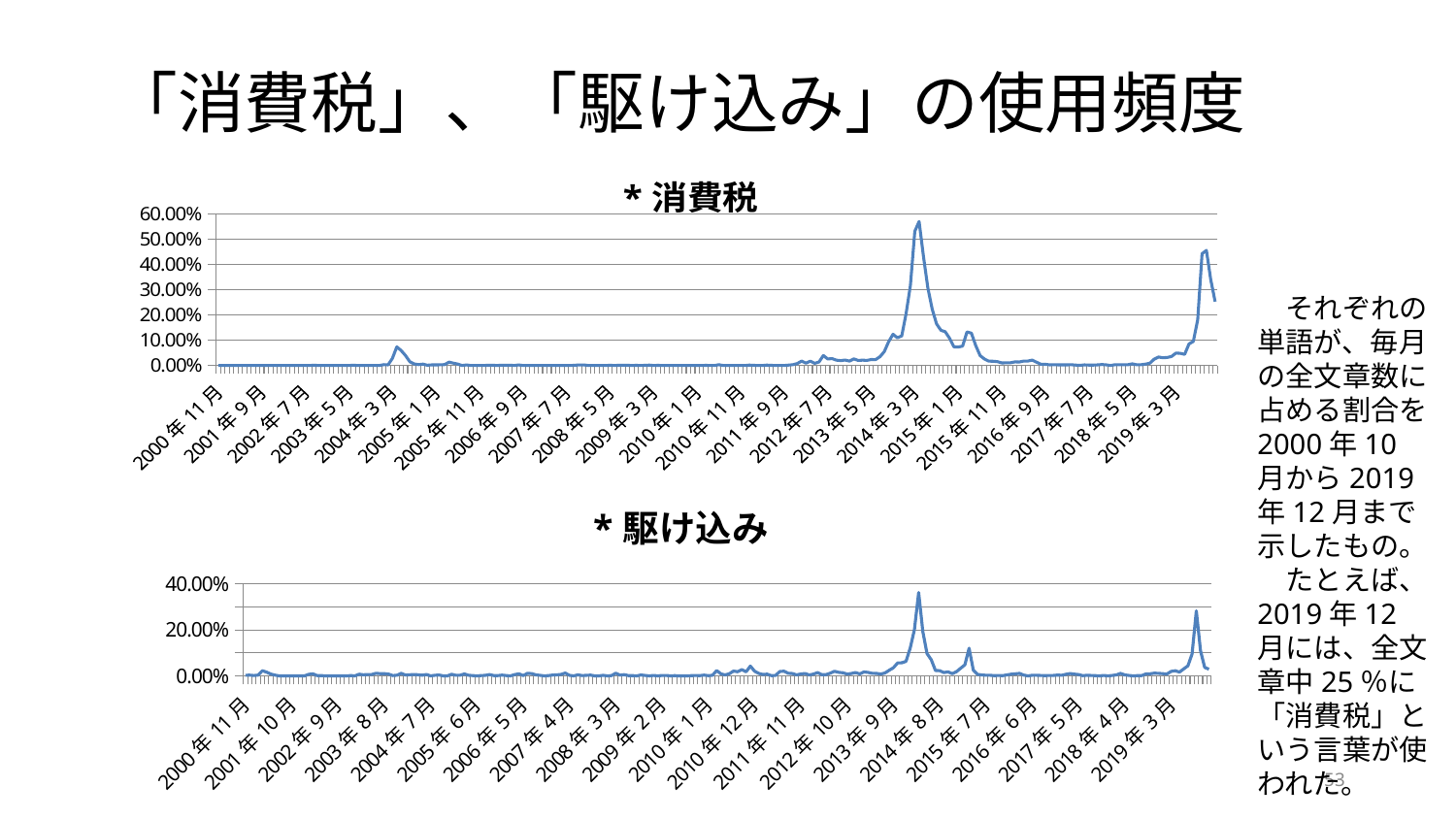
In the top chart ＊消費税, is the small peak near 2004年3月 greater or less than 10%? less What kind of chart is the bottom chart titled ＊駆け込み? line chart In the bottom chart ＊駆け込み, is the peak near 2015年7月 greater or less than 20%? less In the bottom chart ＊駆け込み, is the highest peak near 2014年8月 greater or less than 20%? greater What is the title of the top chart? ＊消費税 What kind of chart is the top chart titled ＊消費税? line chart In the bottom chart ＊駆け込み, which is larger: the peak near 2014年8月 or the peak near 2015年7月? the peak near 2014年8月 What is the title of the bottom chart? ＊駆け込み In the top chart ＊消費税, which is larger: the peak near 2014年3月 or the peak near 2015年1月? the peak near 2014年3月 What is the highest value shown on the y-axis of the top chart ＊消費税? 60.00% In the top chart ＊消費税, around which x-axis label does the line reach its highest point? 2014年3月